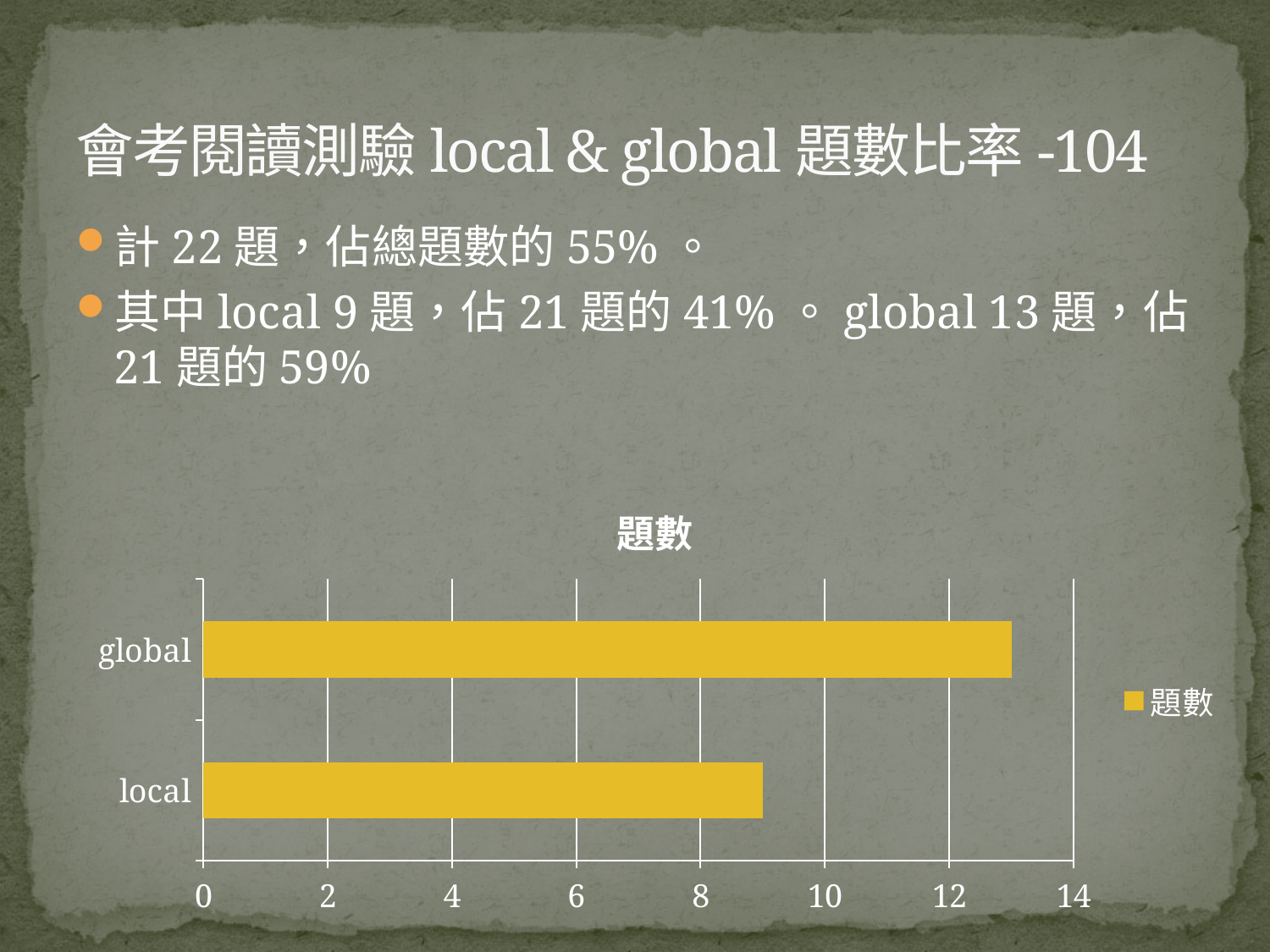
What is the title of the chart? 題數 Is the value for global greater or less than 12? greater How many series does the chart legend list? 1 Which has the larger value in the chart, global or local? global Which category has the lowest value in the chart? local Is the value for local greater or less than 8? greater What is the name of the series shown in the chart legend? 題數 Which category has the highest value in the chart? global Is the value for global greater or less than 14? less How many categories are plotted in the chart? 2 What kind of chart is shown on the slide? bar chart